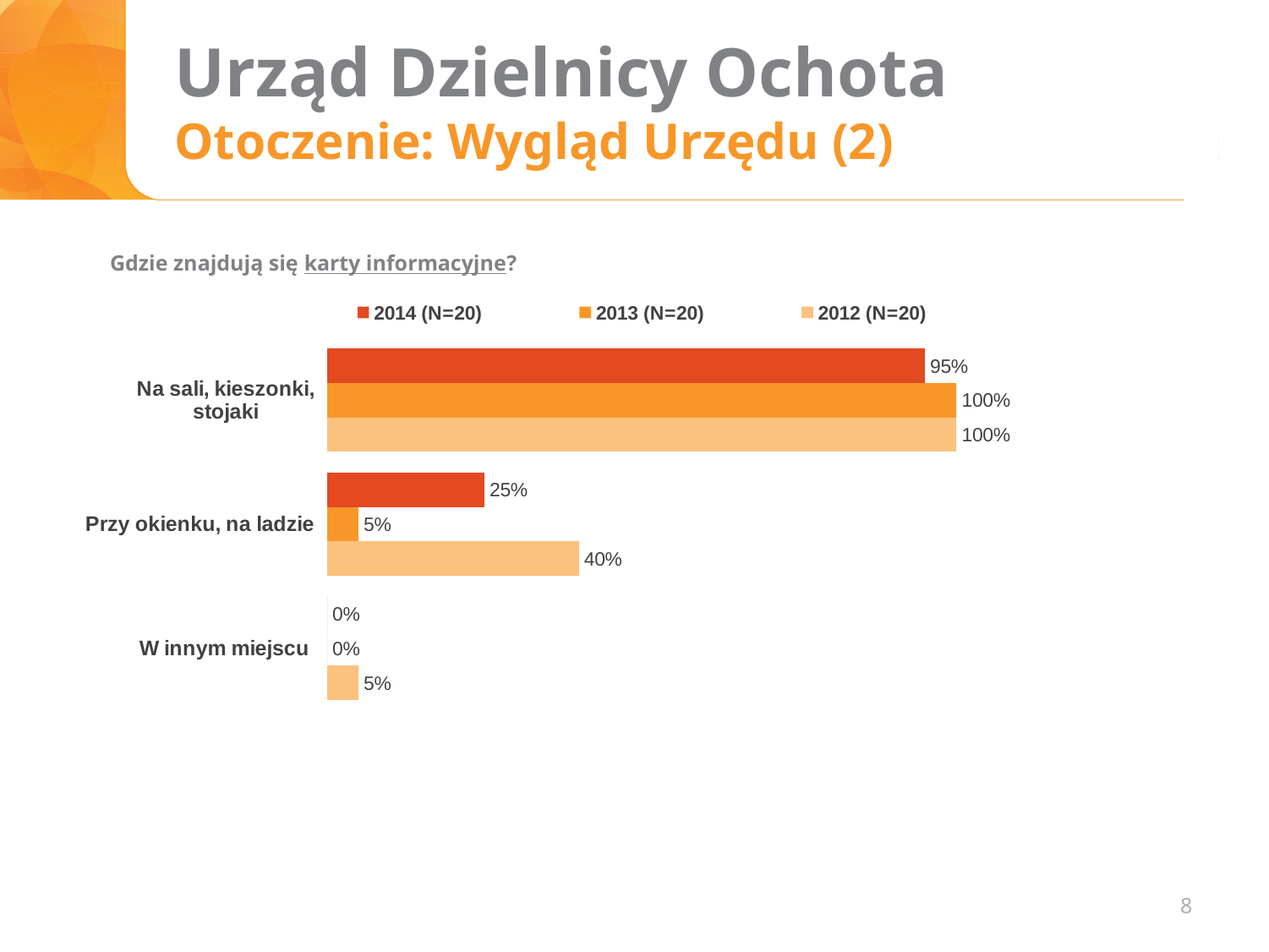
Which category has the lowest value in the 2014 (N=20) series? W innym miejscu For "Przy okienku, na ladzie", which series has the larger value: 2014 (N=20) or 2013 (N=20)? 2014 (N=20) How many categories are shown on the chart? 3 What is the difference between the 2013 (N=20) and 2014 (N=20) values for "Na sali, kieszonki, stojaki"? 5% What kind of chart is shown on the slide? Bar chart How many series does the legend list? 3 What is the value for "Na sali, kieszonki, stojaki" in the 2014 (N=20) series? 95% What is the difference between the 2012 (N=20) and 2014 (N=20) values for "Przy okienku, na ladzie"? 15% What is the value for "Przy okienku, na ladzie" in the 2013 (N=20) series? 5% What is the value for "W innym miejscu" in the 2013 (N=20) series? 0% Which category has the highest value in the 2012 (N=20) series? Na sali, kieszonki, stojaki What is the value for "Przy okienku, na ladzie" in the 2012 (N=20) series? 40%